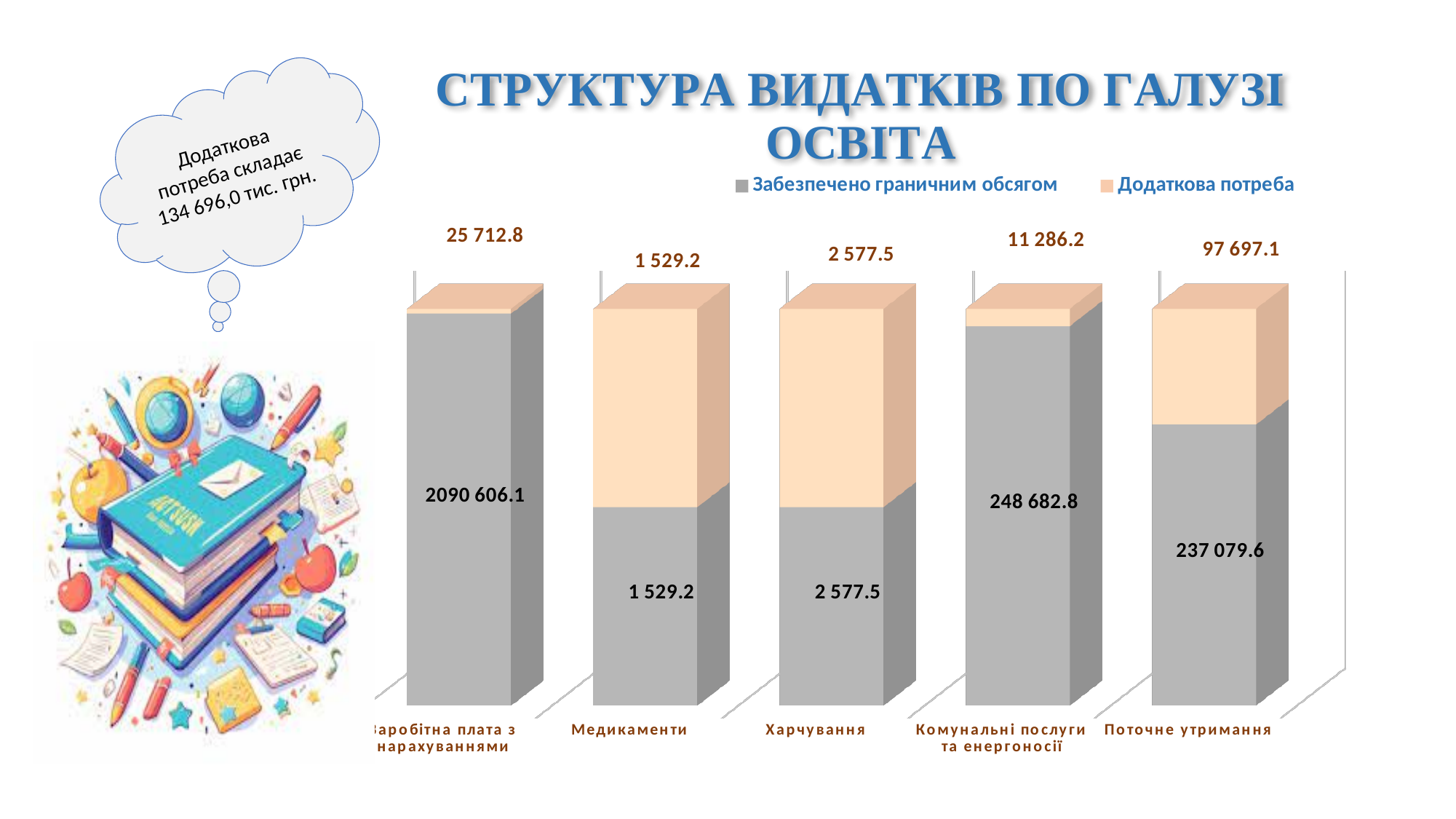
Which category has the lowest value of Забезпечено граничним обсягом? Медикаменти Which category has the highest value of Додаткова потреба? Поточне утримання What is the value of Забезпечено граничним обсягом for Заробітна плата з нарахуваннями? 2090 606.1 What is the title of the chart? СТРУКТУРА ВИДАТКІВ ПО ГАЛУЗІ ОСВІТА What is the value of Додаткова потреба for Поточне утримання? 97 697.1 What is the value of Забезпечено граничним обсягом for Комунальні послуги та енергоносії? 248 682.8 Which is larger for Комунальні послуги та енергоносії: Забезпечено граничним обсягом or Додаткова потреба? Забезпечено граничним обсягом How many series does the legend list? 2 What kind of chart is shown on the slide? Stacked bar chart What is the value of Додаткова потреба for Харчування? 2 577.5 What is the difference between Забезпечено граничним обсягом and Додаткова потреба for Поточне утримання? 139 382.5 How many categories are shown on the x axis of the chart? 5